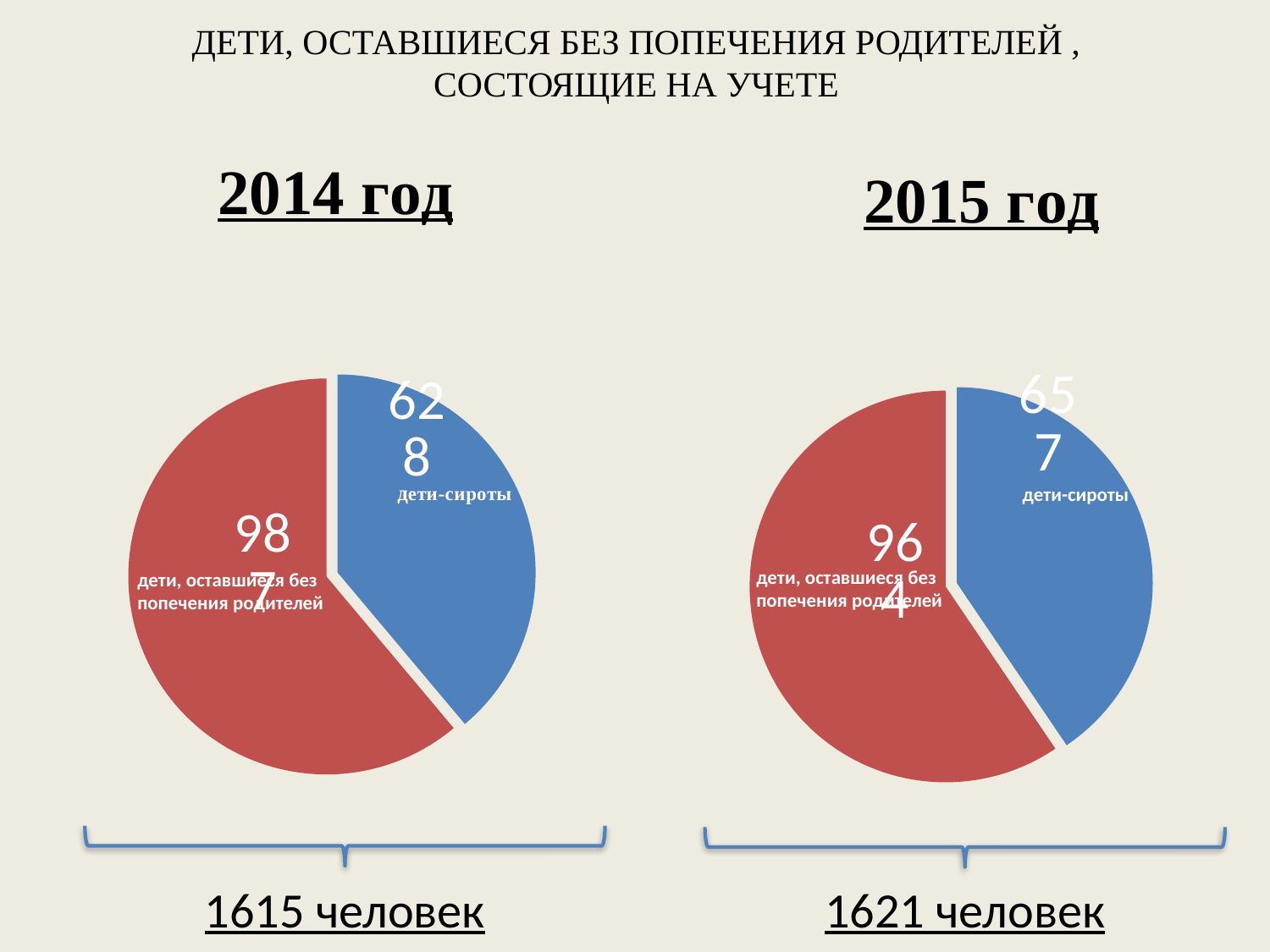
In the 2015 год pie chart, what is the difference between дети, оставшиеся без попечения родителей and дети-сироты? 307 In the 2014 год pie chart, what is the difference between дети, оставшиеся без попечения родителей and дети-сироты? 359 In the 2015 год pie chart, what is the value for дети-сироты? 657 What type of chart is used for the 2014 год data? pie chart In the 2014 год pie chart, what is the value for дети, оставшиеся без попечения родителей? 987 In the 2015 год pie chart, what is the value for дети, оставшиеся без попечения родителей? 964 In the 2014 год pie chart, which category has the largest slice? дети, оставшиеся без попечения родителей In the 2015 год pie chart, which category has the smallest slice? дети-сироты Which is larger: дети-сироты in the 2014 год chart or дети-сироты in the 2015 год chart? 2015 год What total number of people is shown under the 2015 год pie chart? 1621 человек How many slices does the 2015 год pie chart have? 2 In the 2014 год pie chart, what is the value for дети-сироты? 628